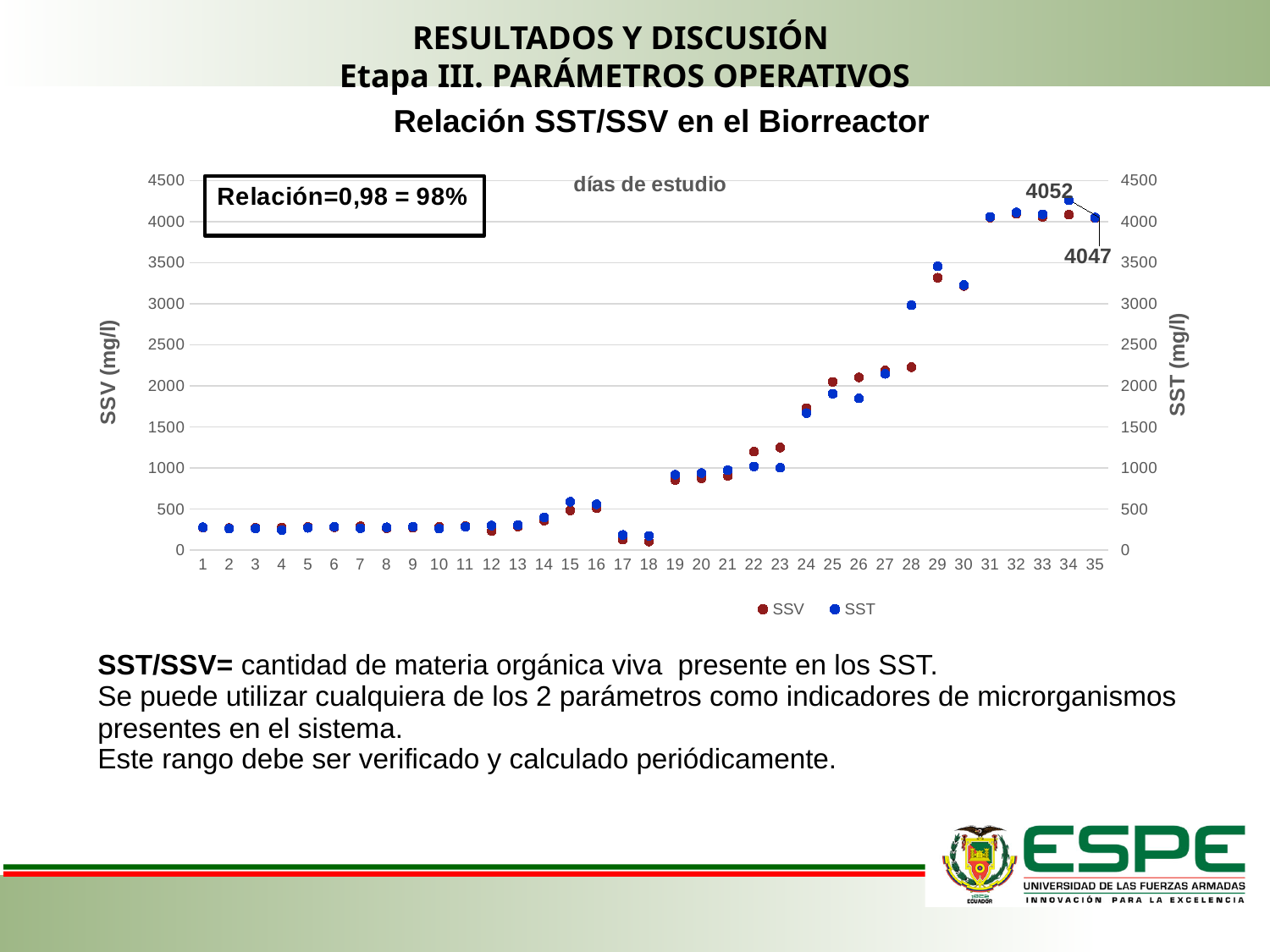
Is the SSV value on day 22 greater or less than 1000? greater Is the SST value on day 29 greater or less than 3000? greater What two data labels are printed on the chart near the last points? 4052 and 4047 How many series does the legend list? 2 How many days of study are shown on the x axis? 35 Is the SSV value on day 17 greater or less than 500? less What ratio is stated in the box at the top left of the chart? Relación=0,98 = 98% On day 26, which series has the larger value, SSV or SST? SSV On which day does the SST series reach its highest value? 34 What kind of chart is shown on the slide? scatter chart Do the SST values generally rise or fall from day 1 to day 35? rise On day 29, which series has the larger value, SSV or SST? SST